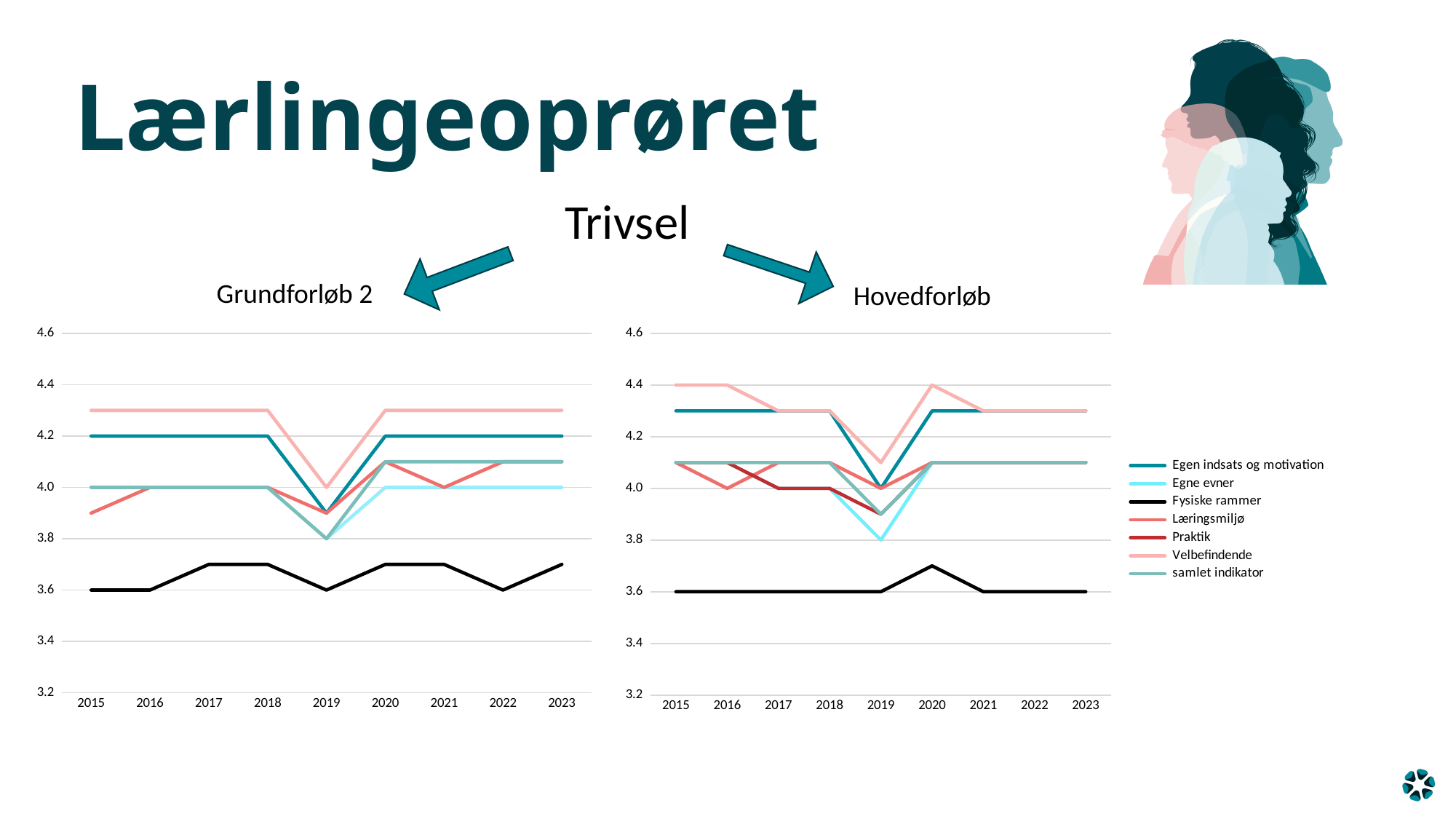
What kind of chart is the Grundforløb 2 chart? Line chart In the Grundforløb 2 chart, what is the value for Fysiske rammer in 2015? 3.6 In the Hovedforløb chart, what is the value for Velbefindende in 2015? 4.4 In the Grundforløb 2 chart, what is the value for Egen indsats og motivation in 2015? 4.2 How many years are shown on the x axis of the Hovedforløb chart? 9 In the Hovedforløb chart, is the value for Egen indsats og motivation in 2015 greater or less than 4.2? greater In the Grundforløb 2 chart, which series has the lowest value in 2015? Fysiske rammer In the Hovedforløb chart, what is the value for Egne evner in 2019? 3.8 How many series does the legend list? 7 In the Grundforløb 2 chart, which is larger in 2019: Velbefindende or Fysiske rammer? Velbefindende In the Hovedforløb chart, which series has the highest value in 2015? Velbefindende In the Grundforløb 2 chart, what is the difference between Egen indsats og motivation and Fysiske rammer in 2015? 0.6